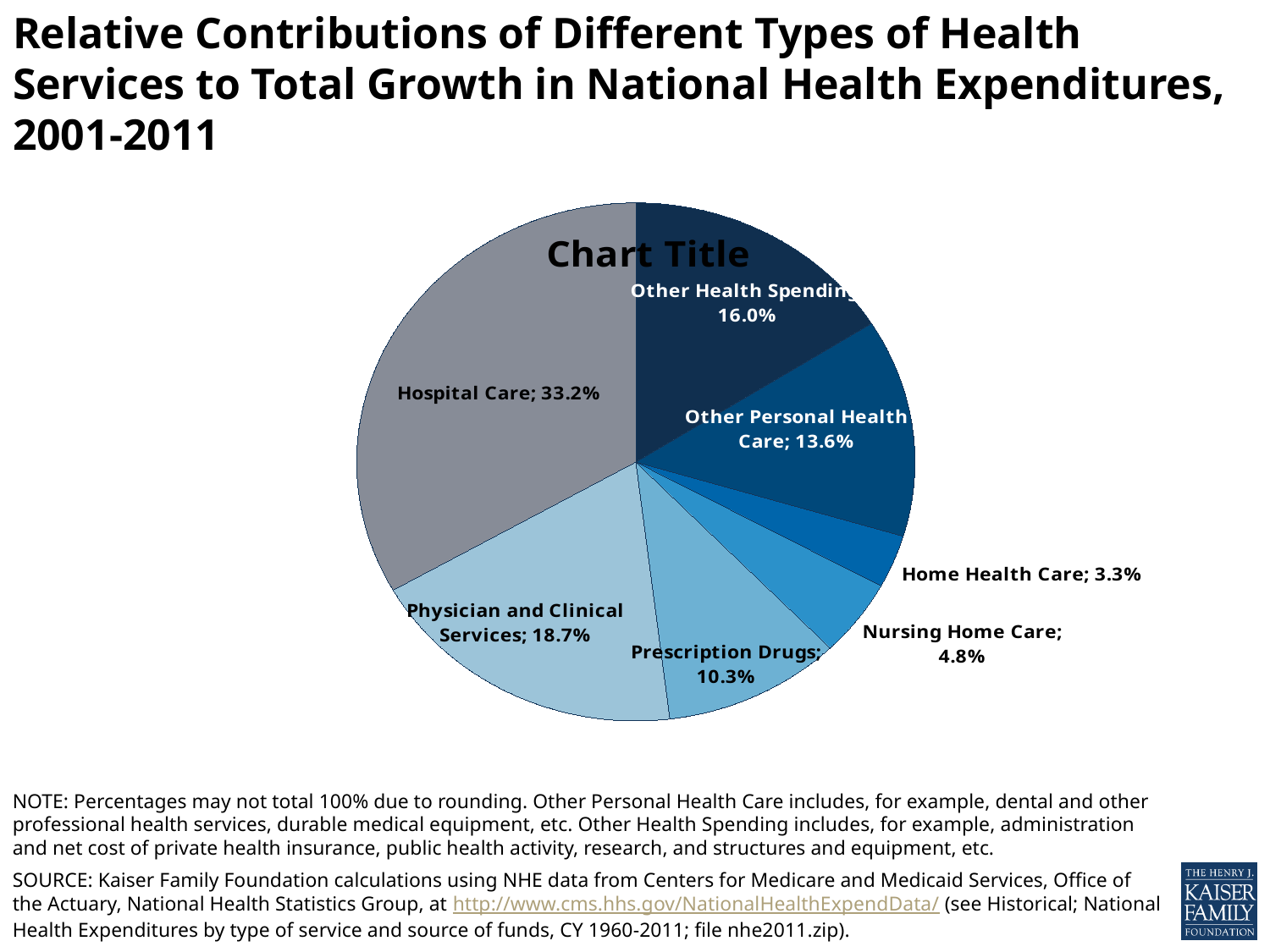
What percentage is shown for Nursing Home Care? 4.8% How many slices does the pie chart have? 7 Which type of health service contributed the largest share to total growth? Hospital Care What percentage is shown for Prescription Drugs? 10.3% What type of chart is shown on the slide? Pie chart What is the combined share of Nursing Home Care and Home Health Care? 8.1% What share of total growth in national health expenditures is attributed to Hospital Care? 33.2% Which is larger, the share for Other Personal Health Care or the share for Prescription Drugs? Other Personal Health Care What percentage is shown for Other Health Spending? 16.0% What is the difference in percentage points between Hospital Care and Physician and Clinical Services? 14.5 What percentage is shown for Physician and Clinical Services? 18.7% Which type of health service contributed the smallest share to total growth? Home Health Care